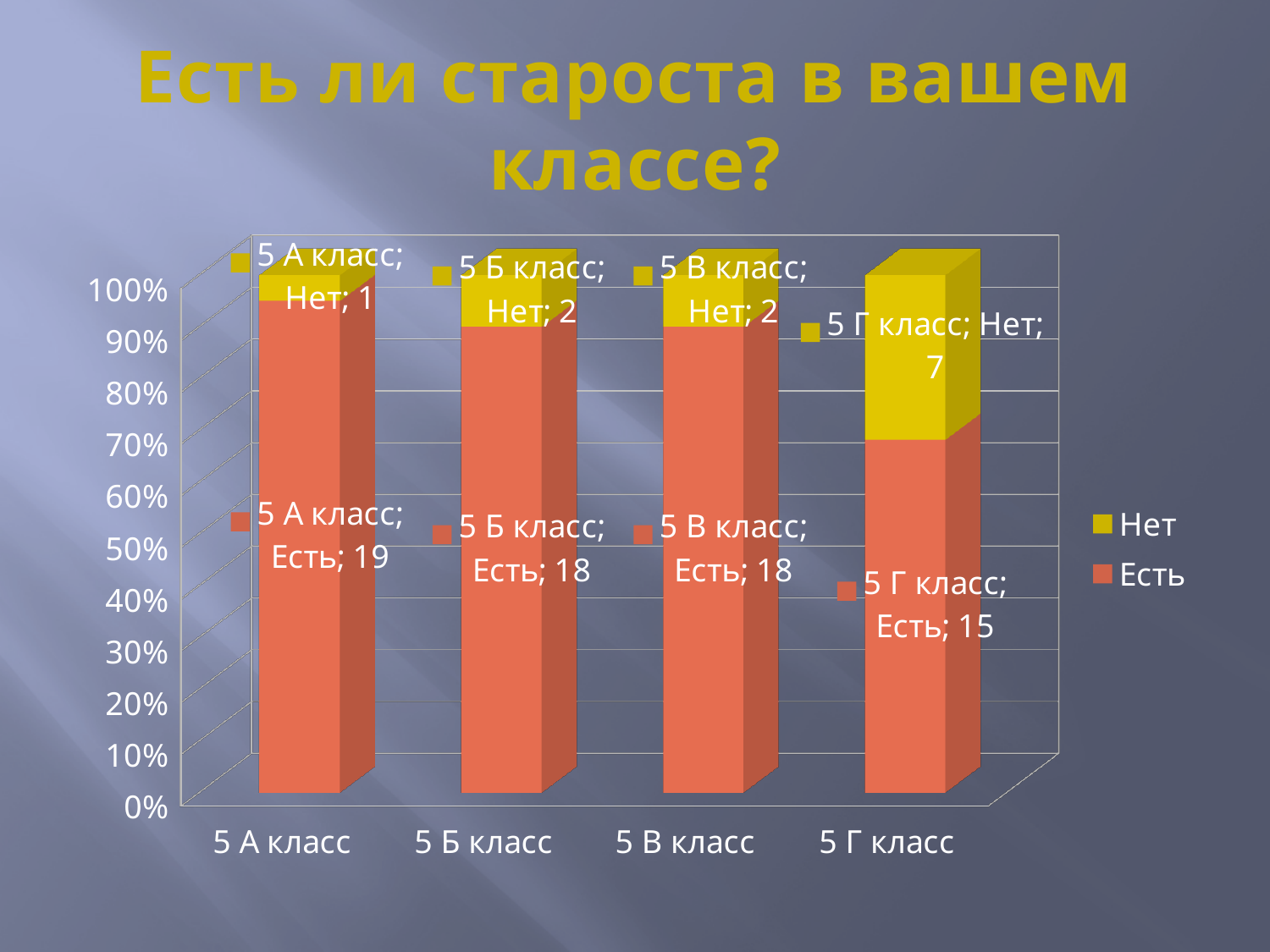
How many classes are shown on the x axis? 4 Which class has the lowest "Нет" value? 5 А класс Which class has the lowest "Есть" value? 5 Г класс What is the value labelled for "Есть" in 5 А класс? 19 What kind of chart is shown on the slide? Stacked bar chart How many series does the legend list? 2 Which class has the highest "Нет" value? 5 Г класс Which is larger: the "Нет" value for 5 Б класс or for 5 Г класс? 5 Г класс What is the difference between the "Есть" and "Нет" values for 5 Г класс? 8 What is the value labelled for "Есть" in 5 В класс? 18 What is the total of the two labelled values for 5 Г класс? 22 What is the value labelled for "Нет" in 5 Г класс? 7